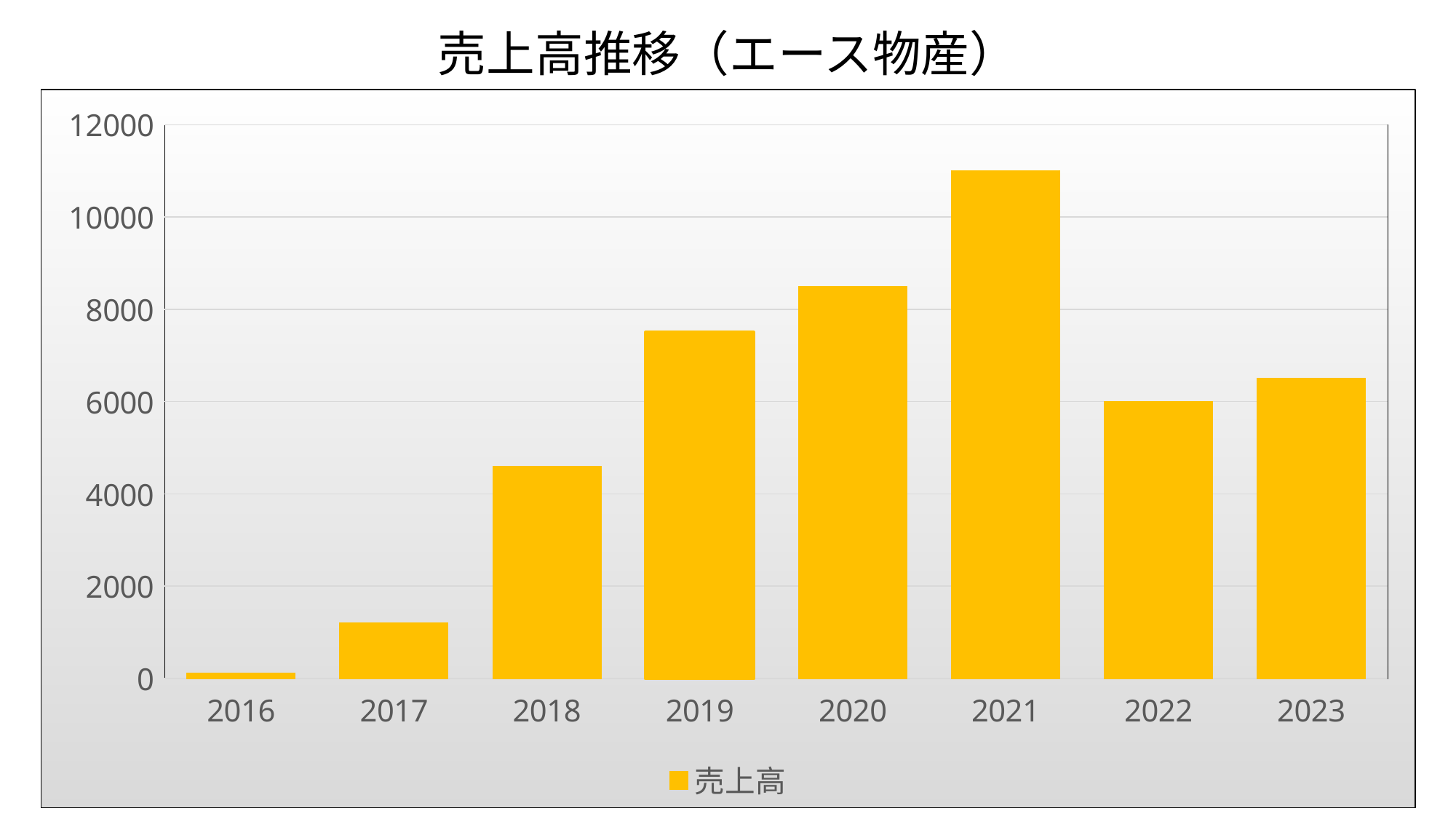
Which is larger, the value for 2020 or the value for 2023? 2020 Do the values rise or fall from 2016 to 2021? rise How many years are shown on the x axis? 8 Is the value for 2019 greater or less than 8000? less Is the value for 2017 greater or less than 2000? less Which year has the highest 売上高? 2021 How many series does the legend list? 1 What kind of chart is shown on the slide? bar chart Is the value for 2018 greater or less than 4000? greater Which year has the lowest 売上高? 2016 What is the title of the chart? 売上高推移（エース物産）